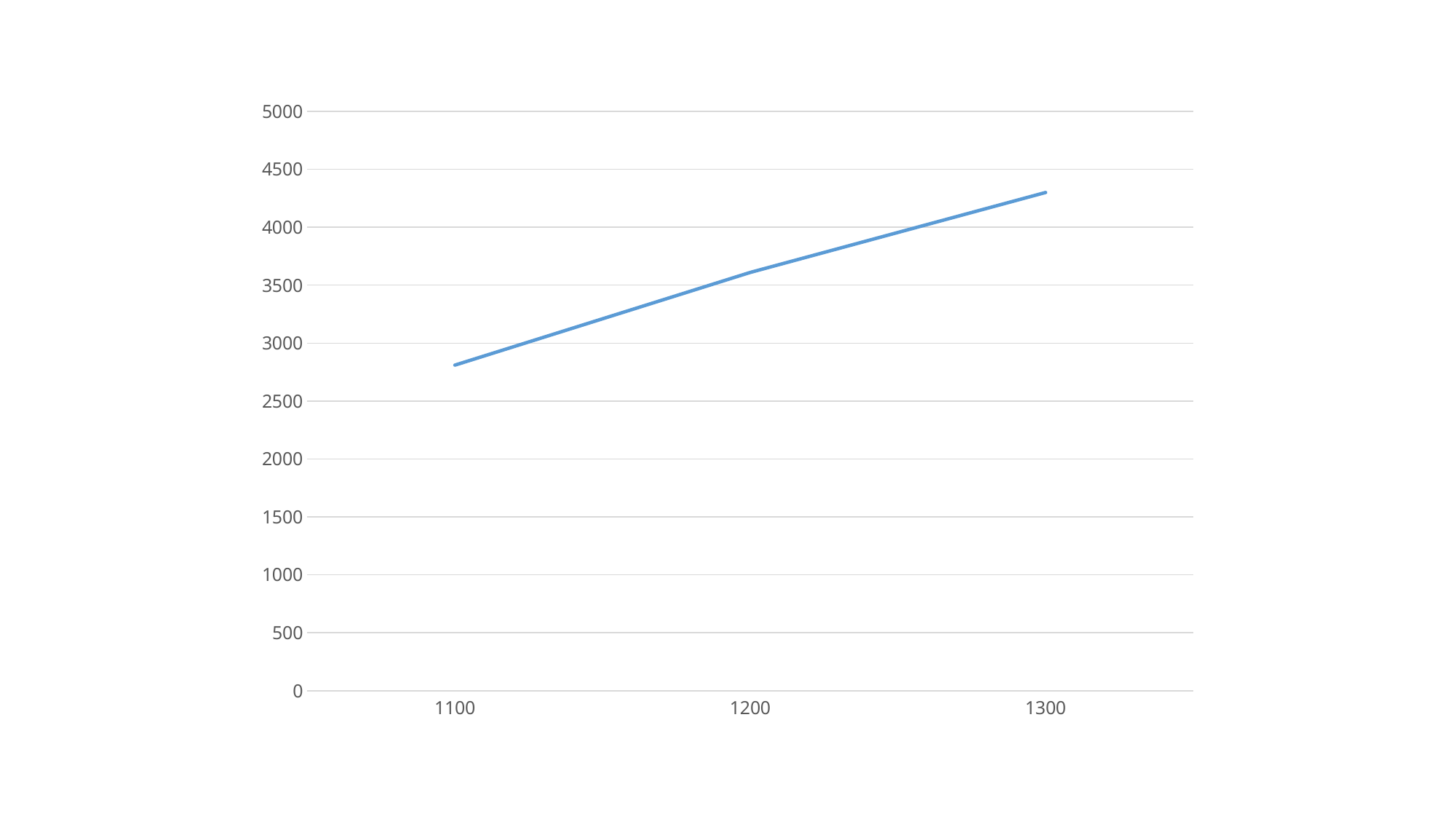
Which has the larger value, 1200 or 1300? 1300 Is the value for 1100 greater or less than 3000? less What kind of chart is shown on the slide? line chart Which x-axis category has the highest value? 1300 Which x-axis category has the lowest value? 1100 Is the value for 1200 greater or less than 3000? greater Is the value for 1300 greater or less than 4500? less Do the values rise or fall as the x axis goes from 1100 to 1300? rise Which has the larger value, 1100 or 1200? 1200 How many points are plotted on the line? 3